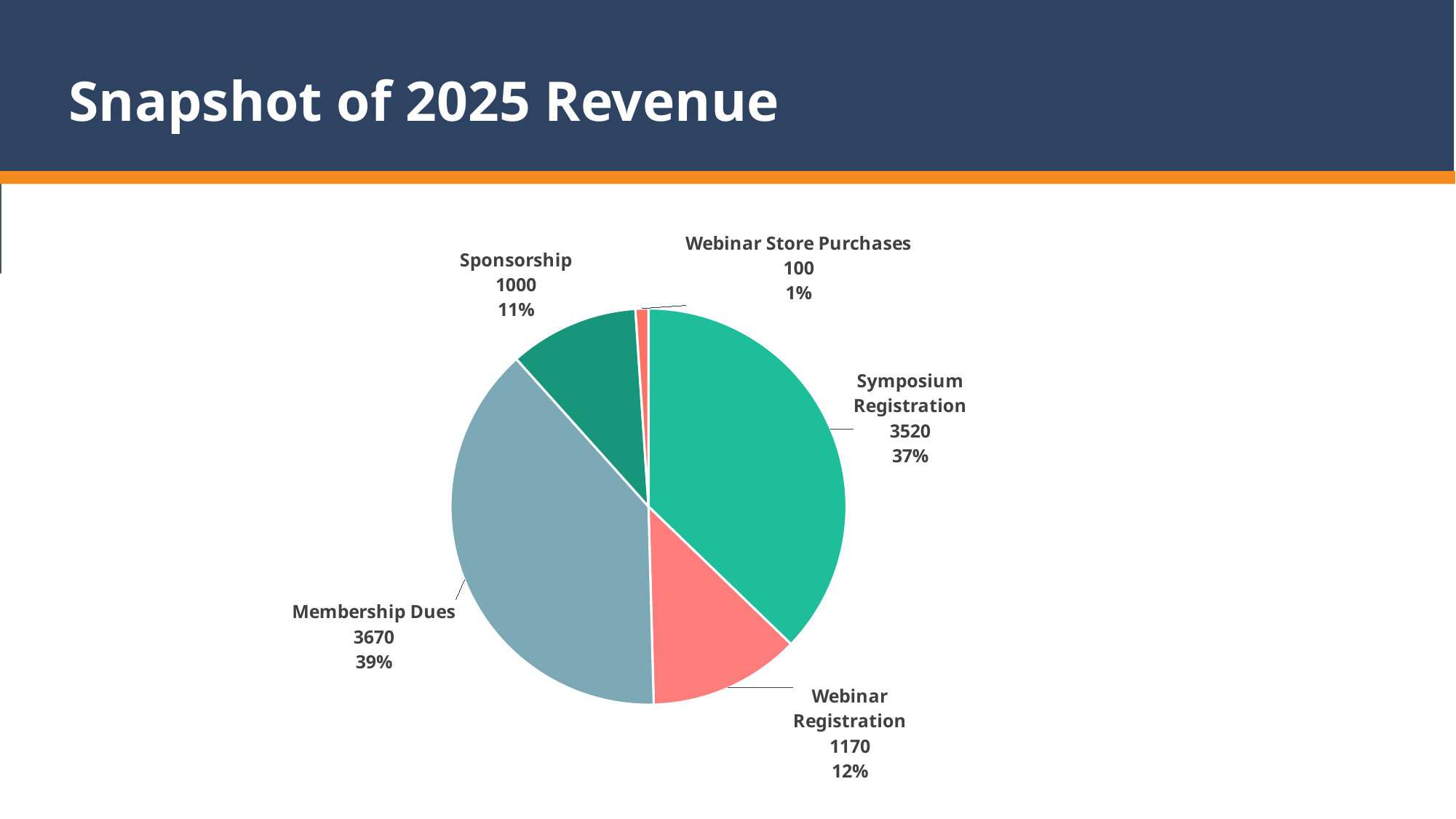
What share of the pie does Sponsorship represent? 11% What is the difference between the values for Membership Dues and Symposium Registration? 150 Which category has the largest slice of the pie? Membership Dues What is the value for Webinar Registration? 1170 What is the value for Symposium Registration? 3520 Which is larger, the value for Webinar Registration or the value for Sponsorship? Webinar Registration What share of the pie does Symposium Registration represent? 37% What kind of chart is shown on the slide? Pie chart Which category has the smallest slice of the pie? Webinar Store Purchases What is the value for Membership Dues? 3670 How many categories are shown in the pie chart? 5 What is the value for Webinar Store Purchases? 100